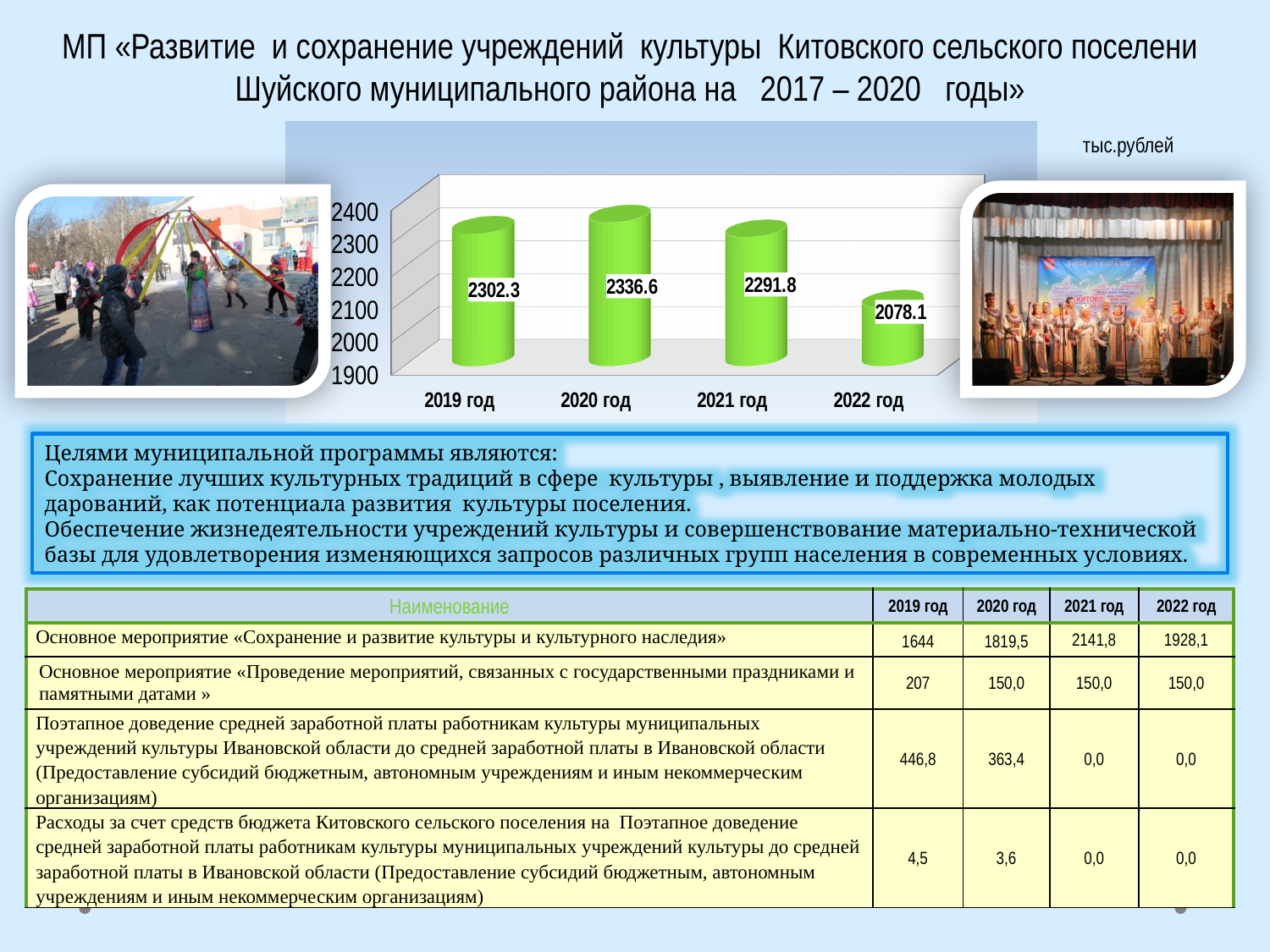
What is the difference between the values for 2019 год and 2021 год? 10.5 What unit is indicated for the chart values? тыс.рублей How many years are plotted in the chart? 4 What is the value shown for 2021 год? 2291.8 Which year has the highest value in the chart? 2020 год Is the value for 2022 год greater or less than 2100? less What is the difference between the values for 2020 год and 2022 год? 258.5 What is the value shown for 2019 год? 2302.3 What kind of chart is shown on the slide? bar chart What is the value shown for 2022 год? 2078.1 Which is larger, the value for 2019 год or the value for 2021 год? 2019 год Which year has the lowest value in the chart? 2022 год